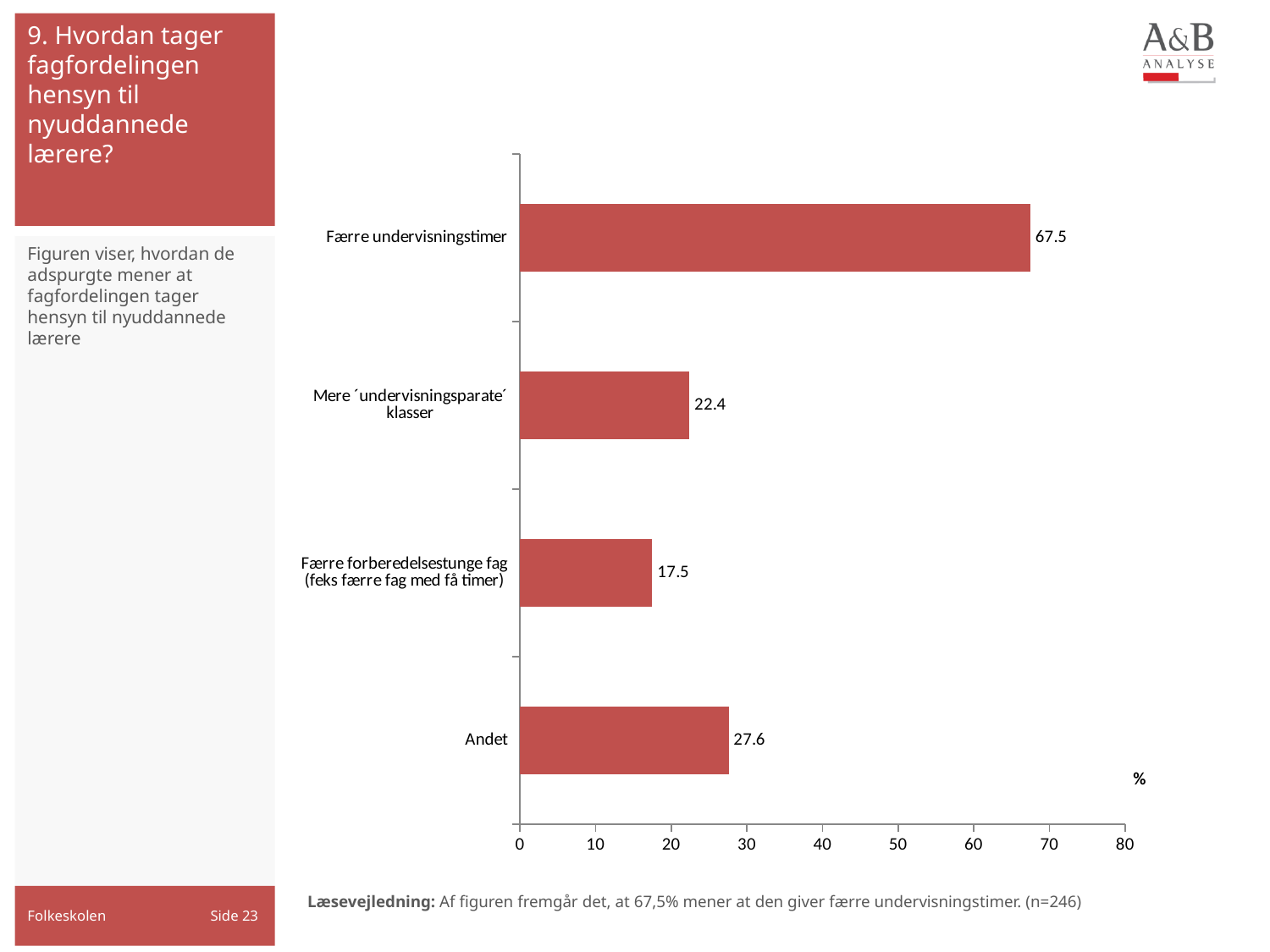
Which is larger: the value for 'Andet' or the value for 'Mere ´undervisningsparate´ klasser'? Andet Which category has the lowest value? Færre forberedelsestunge fag (feks færre fag med få timer) What is the difference between the values for 'Færre undervisningstimer' and 'Andet'? 39.9 What is the value for 'Andet'? 27.6 What kind of chart is shown on the slide? bar chart Is the value for 'Færre undervisningstimer' greater or less than 60? greater What is the value for 'Færre forberedelsestunge fag (feks færre fag med få timer)'? 17.5 What is the maximum value shown on the horizontal axis? 80 Which category has the highest value? Færre undervisningstimer What is the value for 'Færre undervisningstimer'? 67.5 How many categories are shown in the chart? 4 What is the value for 'Mere ´undervisningsparate´ klasser'? 22.4